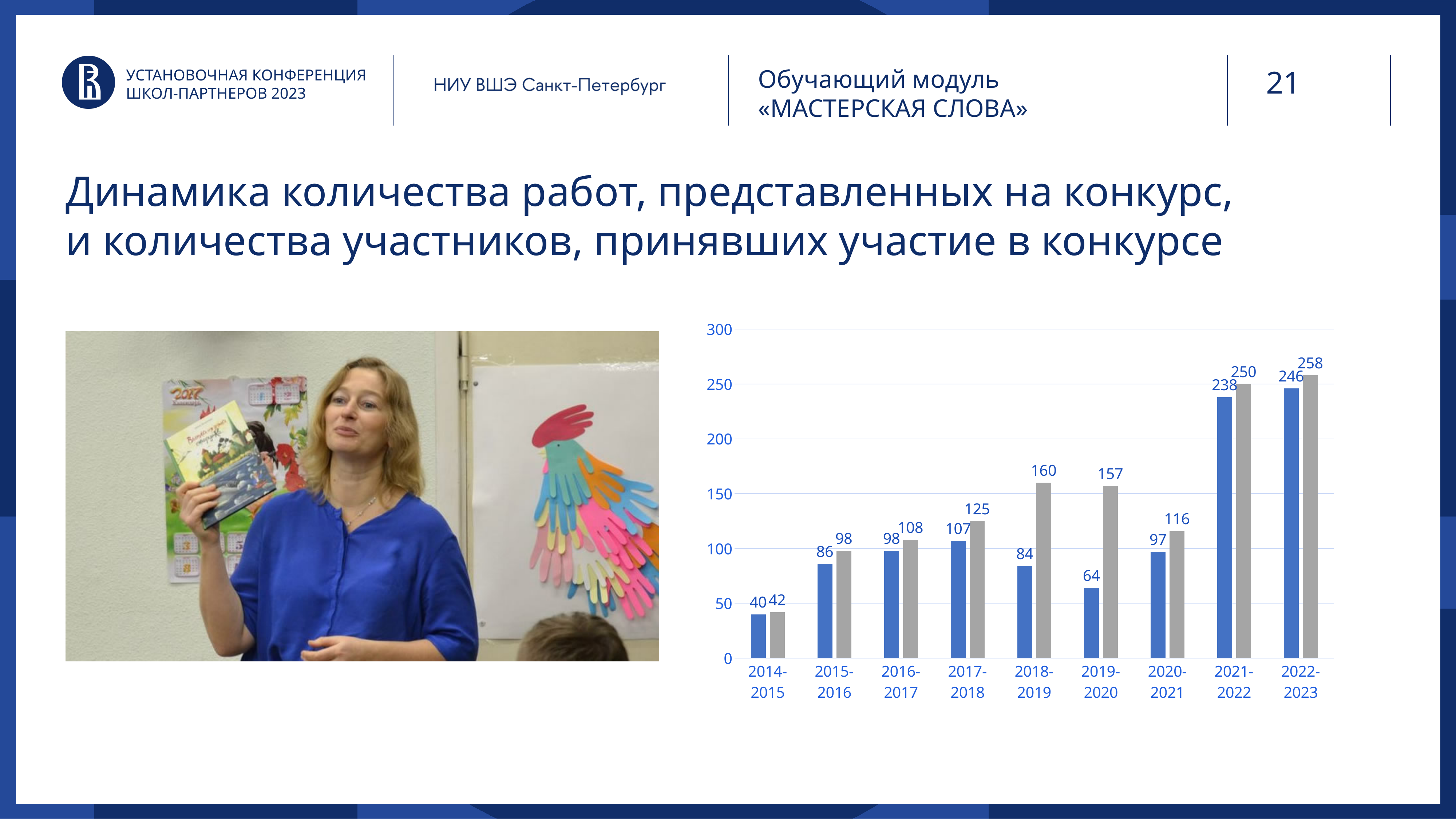
What is the value of the grey bar for 2018-2019? 160 Which year category has the highest grey bar? 2022-2023 Is the value of the grey bar for 2020-2021 greater or less than 100? greater What type of chart is shown on the slide? bar chart How many year categories are shown on the x axis of the chart? 9 What colours are the two bar series in the chart? blue and grey Which is larger: the blue bar for 2017-2018 or the blue bar for 2018-2019? 2017-2018 What is the value of the blue bar for 2019-2020? 64 What is the difference between the grey bar and the blue bar for 2019-2020? 93 What is the value of the grey bar for 2022-2023? 258 What is the value of the blue bar for 2014-2015? 40 Which year category has the lowest blue bar? 2014-2015